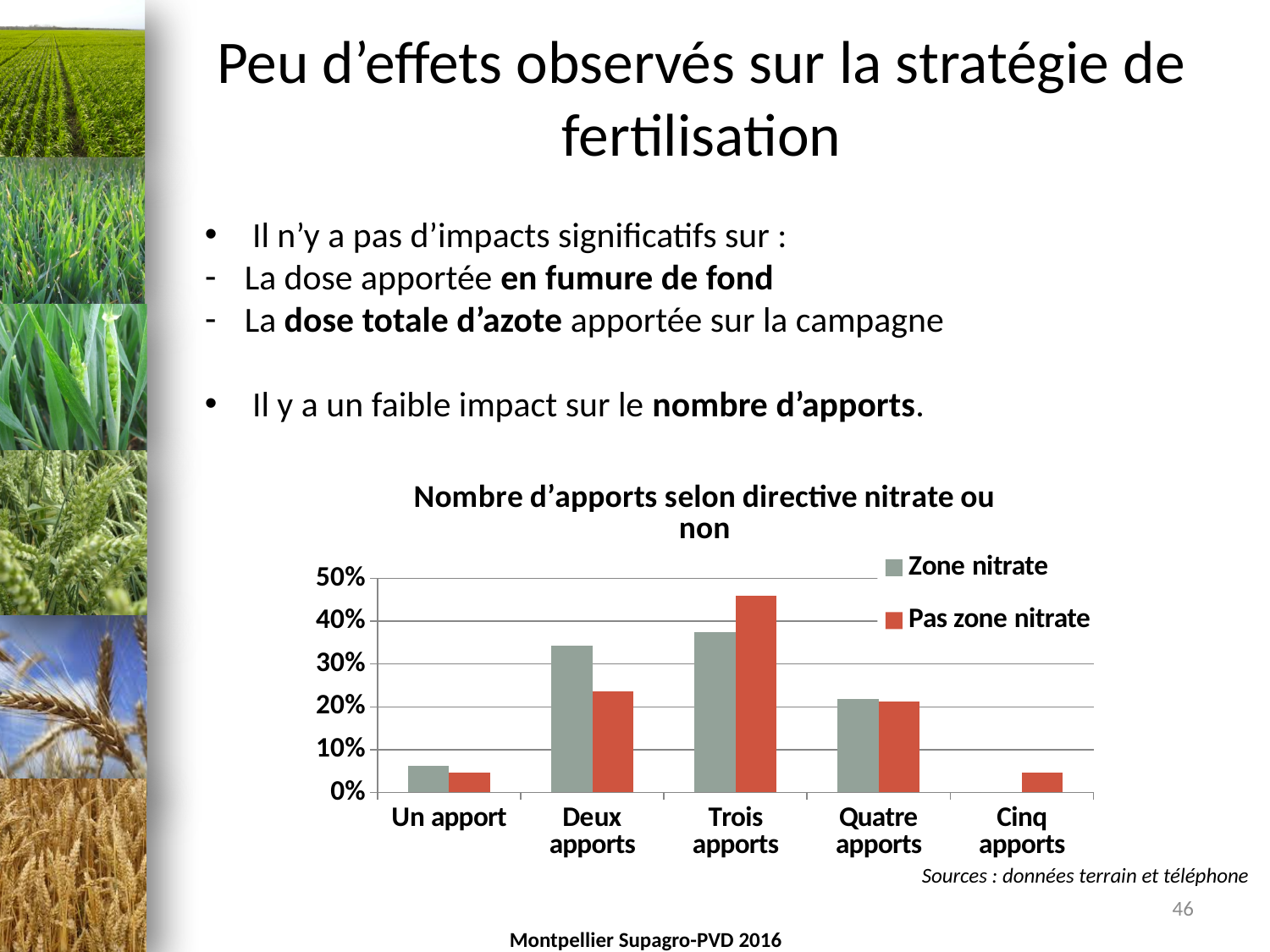
For 'Deux apports', which series has the larger value, 'Zone nitrate' or 'Pas zone nitrate'? Zone nitrate What kind of chart is shown on the slide? bar chart For 'Trois apports', which series has the larger value, 'Zone nitrate' or 'Pas zone nitrate'? Pas zone nitrate Is the 'Zone nitrate' value for 'Deux apports' greater or less than 30%? greater Which category has the highest value for the 'Zone nitrate' series? Trois apports Which category has the lowest value for the 'Zone nitrate' series? Cinq apports How many categories are shown on the x axis of the chart? 5 Is the 'Pas zone nitrate' value for 'Trois apports' greater or less than 40%? greater How many series does the chart legend list? 2 What is the title of the chart? Nombre d'apports selon directive nitrate ou non Is the 'Zone nitrate' value for 'Un apport' greater or less than 10%? less Which category has the highest value for the 'Pas zone nitrate' series? Trois apports